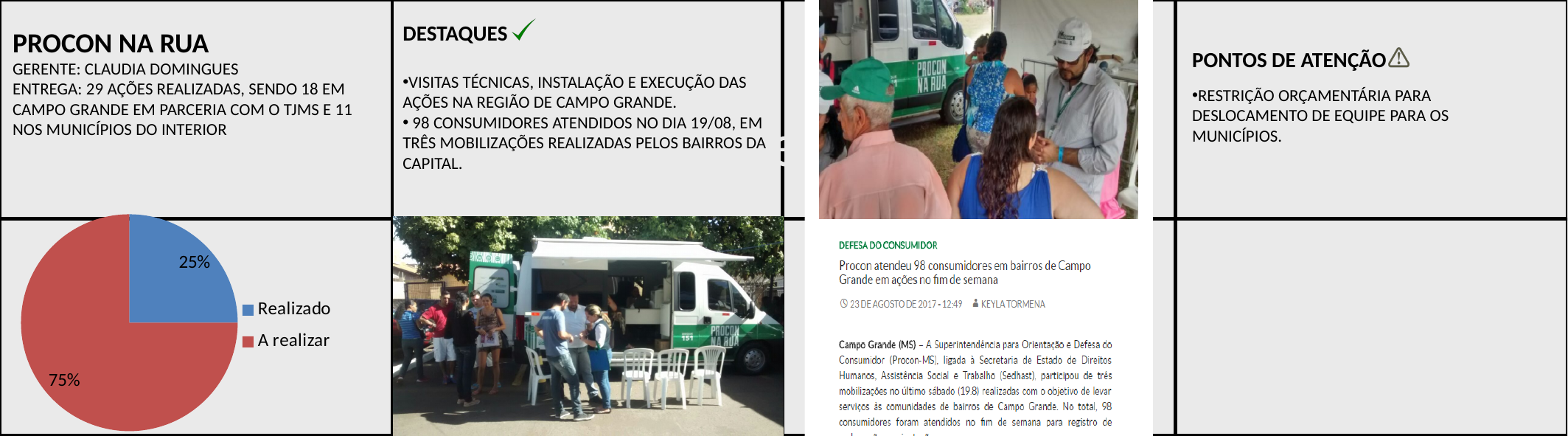
What percentage of the pie chart is labelled "A realizar"? 75% What is the difference in percentage points between the "A realizar" slice and the "Realizado" slice? 50 How many entries does the legend of the pie chart list? 2 What share of the pie does the "Realizado" slice represent? 25% What colour is the "Realizado" slice in the pie chart? blue What kind of chart is shown on the slide? pie chart What percentage of the pie chart is labelled "Realizado"? 25% Which is larger in the pie chart, "Realizado" or "A realizar"? A realizar Which slice of the pie chart is the largest? A realizar Which slice of the pie chart is the smallest? Realizado How many slices does the pie chart have? 2 What colour is the "A realizar" slice in the pie chart? red